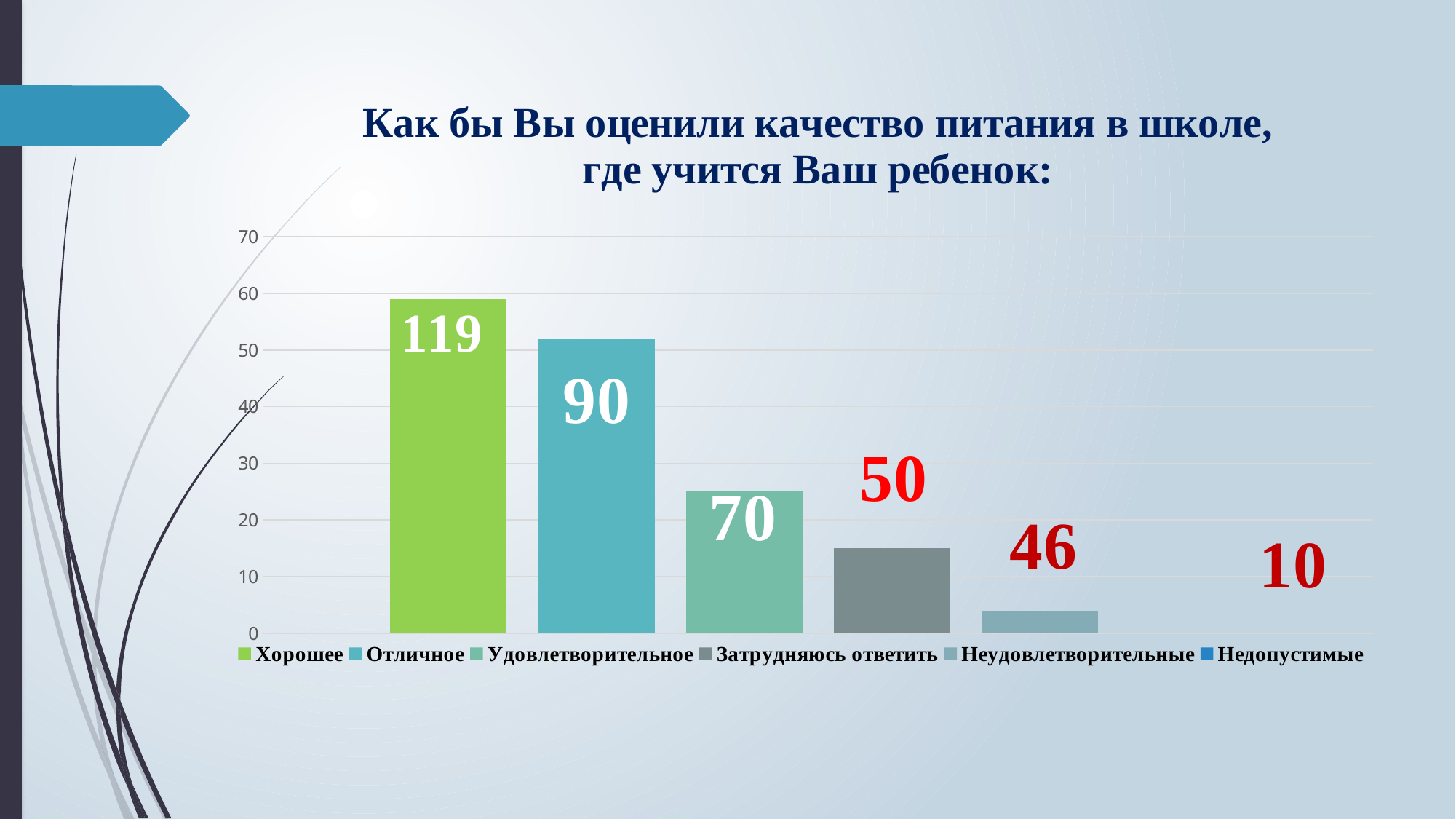
What value is shown for Затрудняюсь ответить? 50 How many entries does the legend list? 6 What value is shown for Удовлетворительное? 70 Which category has the highest value? Хорошее What is the difference between the values for Хорошее and Отличное? 29 What kind of chart is shown on the slide? bar chart What value is shown for Недопустимые? 10 Which is larger, the value for Удовлетворительное or the value for Затрудняюсь ответить? Удовлетворительное What value is shown for Неудовлетворительные? 46 What value is shown for Отличное? 90 What value is shown for Хорошее? 119 Which category has the lowest value? Недопустимые